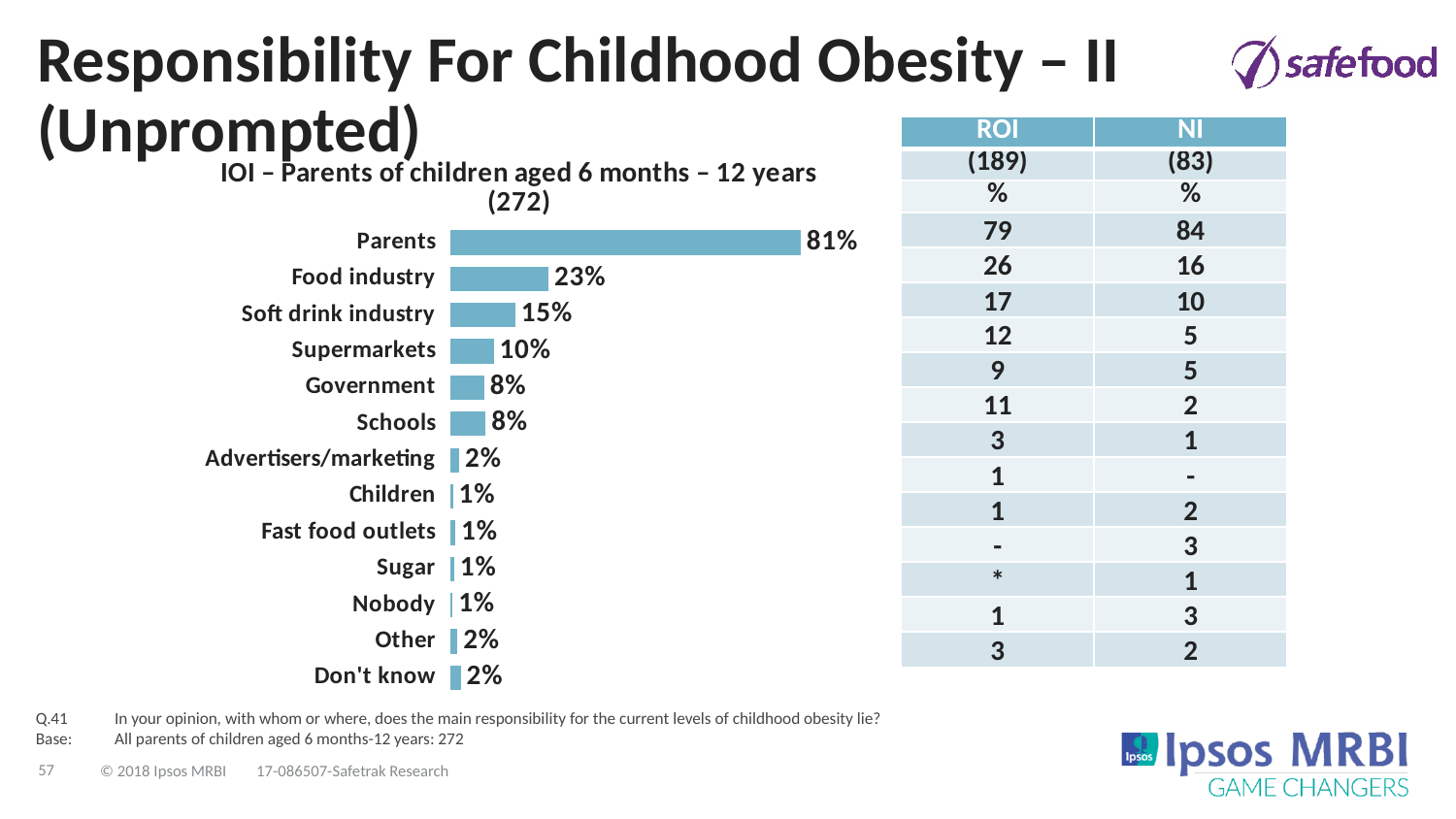
What kind of chart is shown on the slide? Bar chart What is the difference between the values for Parents and Food industry? 58% Which is larger, the value for Supermarkets or the value for Government? Supermarkets What is the value for Supermarkets? 10% What is the value for Soft drink industry? 15% What is the base size shown in the chart title? 272 How many categories are shown in the bar chart? 13 What percentage of parents say Parents are responsible for childhood obesity? 81% Which category has the highest value in the chart? Parents What is the difference between the values for Food industry and Soft drink industry? 8% What is the value for Food industry? 23% What is the value for Advertisers/marketing? 2%